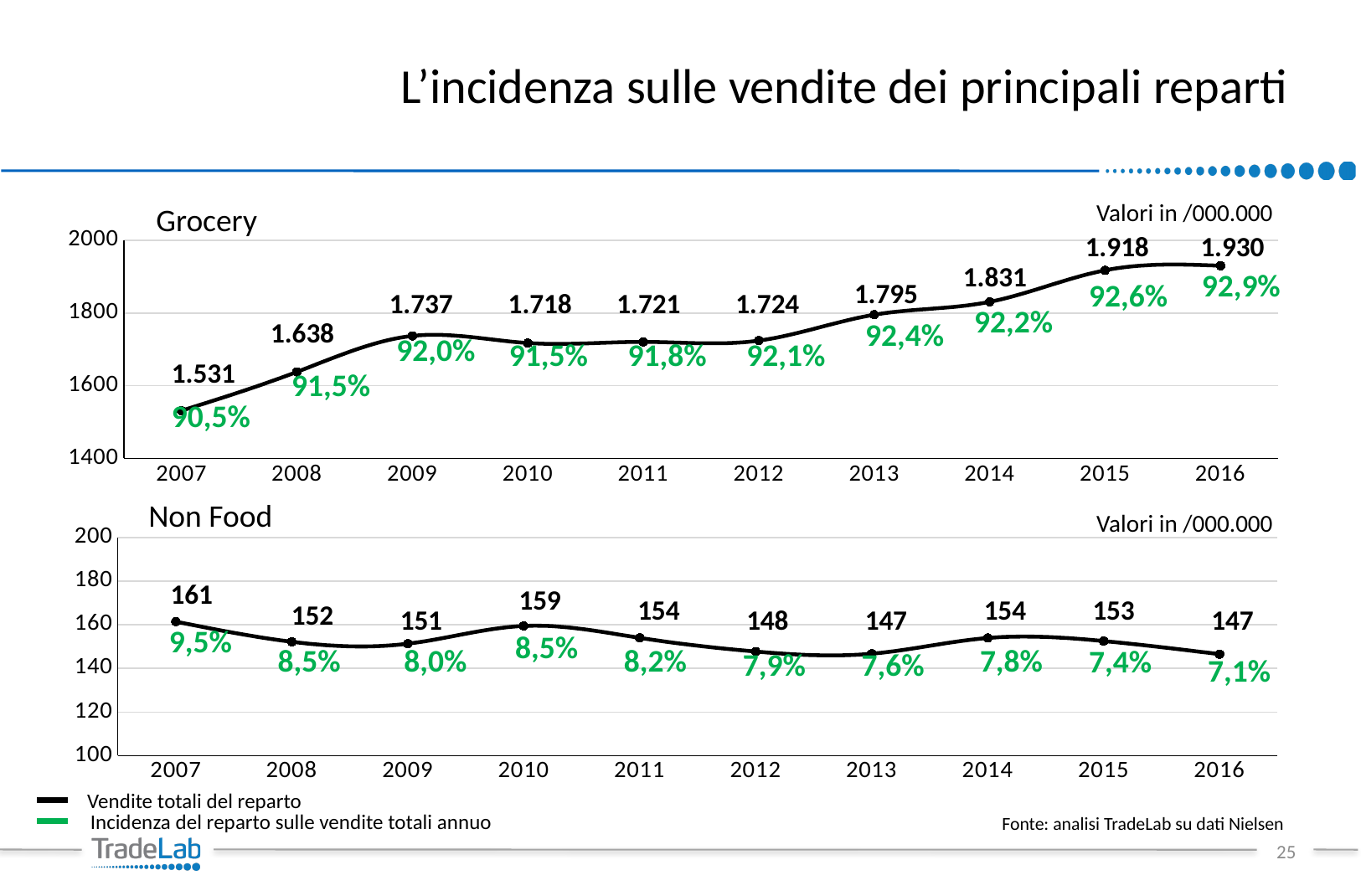
In the Non Food chart, which is larger, the value for 2008 or the value for 2010? 2010 In the Grocery chart, what is the incidence percentage shown for 2016? 92,9% In the Non Food chart, what is the difference between the 2007 value and the 2016 value? 14 In the Grocery chart, which year has the lowest value? 2007 How many years are plotted on the x axis of the Grocery chart? 10 In the Non Food chart, which year has the highest value? 2007 In the Grocery chart, which year has the highest value? 2016 What type of chart is the Non Food chart? Line chart In the Grocery chart, what is the difference between the 2016 value and the 2007 value? 399 In the Non Food chart, what is the value for 2010? 159 In the Non Food chart, what is the incidence percentage shown for 2007? 9,5% In the Grocery chart, what is the value for 2009? 1.737